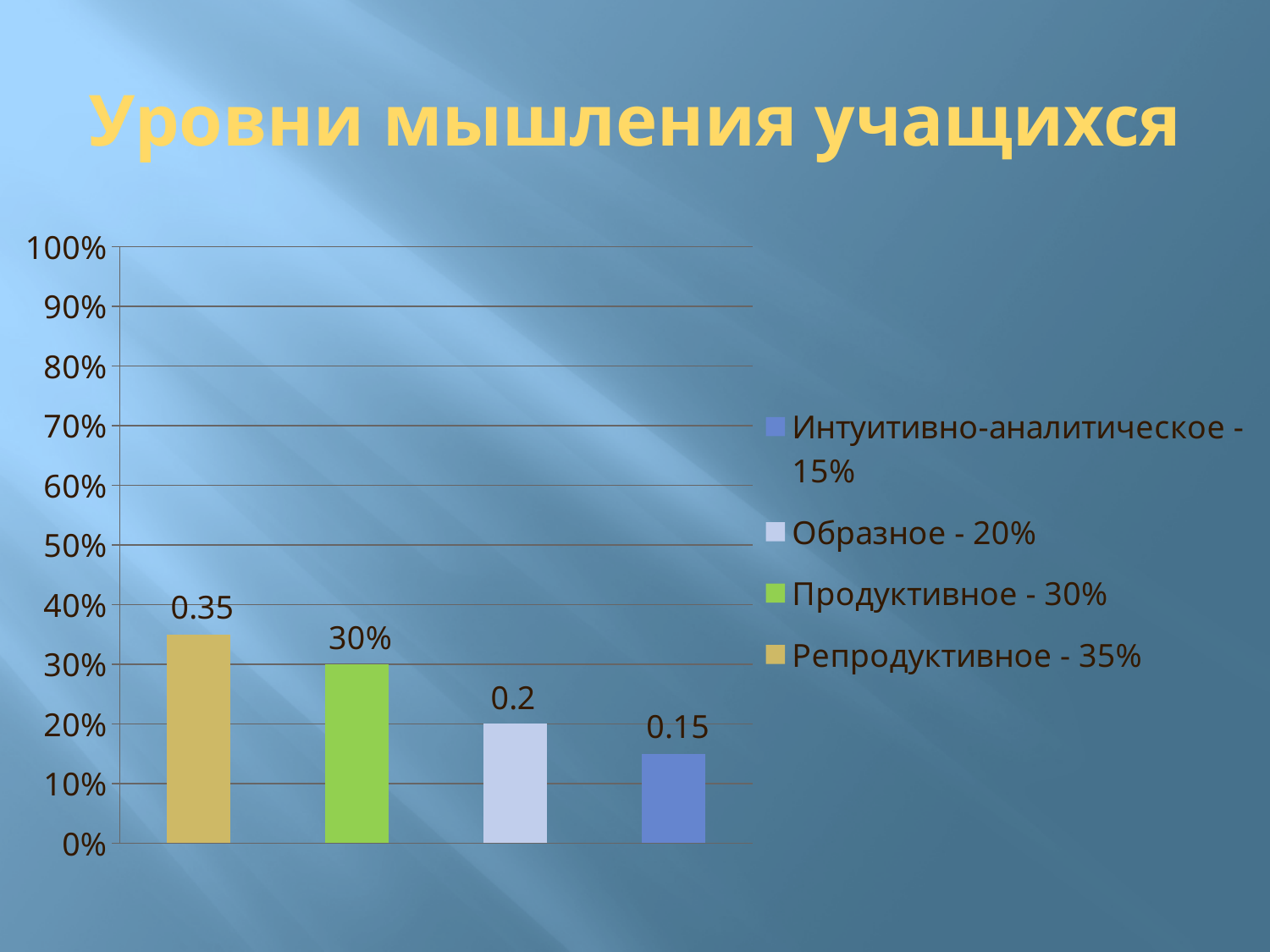
Which legend entry has the highest value? Репродуктивное - 35% How many entries does the legend list? 4 What data label is shown on the bar for Продуктивное? 30% What data label is shown on the bar for Интуитивно-аналитическое? 0.15 Which legend entry has the lowest value? Интуитивно-аналитическое - 15% Is the value for Репродуктивное greater or less than 40%? less What data label is shown on the bar for Репродуктивное? 0.35 Which is larger, the value for Продуктивное or the value for Образное? Продуктивное What kind of chart is shown on the slide? bar chart What data label is shown on the bar for Образное? 0.2 What is the title of the chart? Уровни мышления учащихся How many bars are plotted in the chart? 4